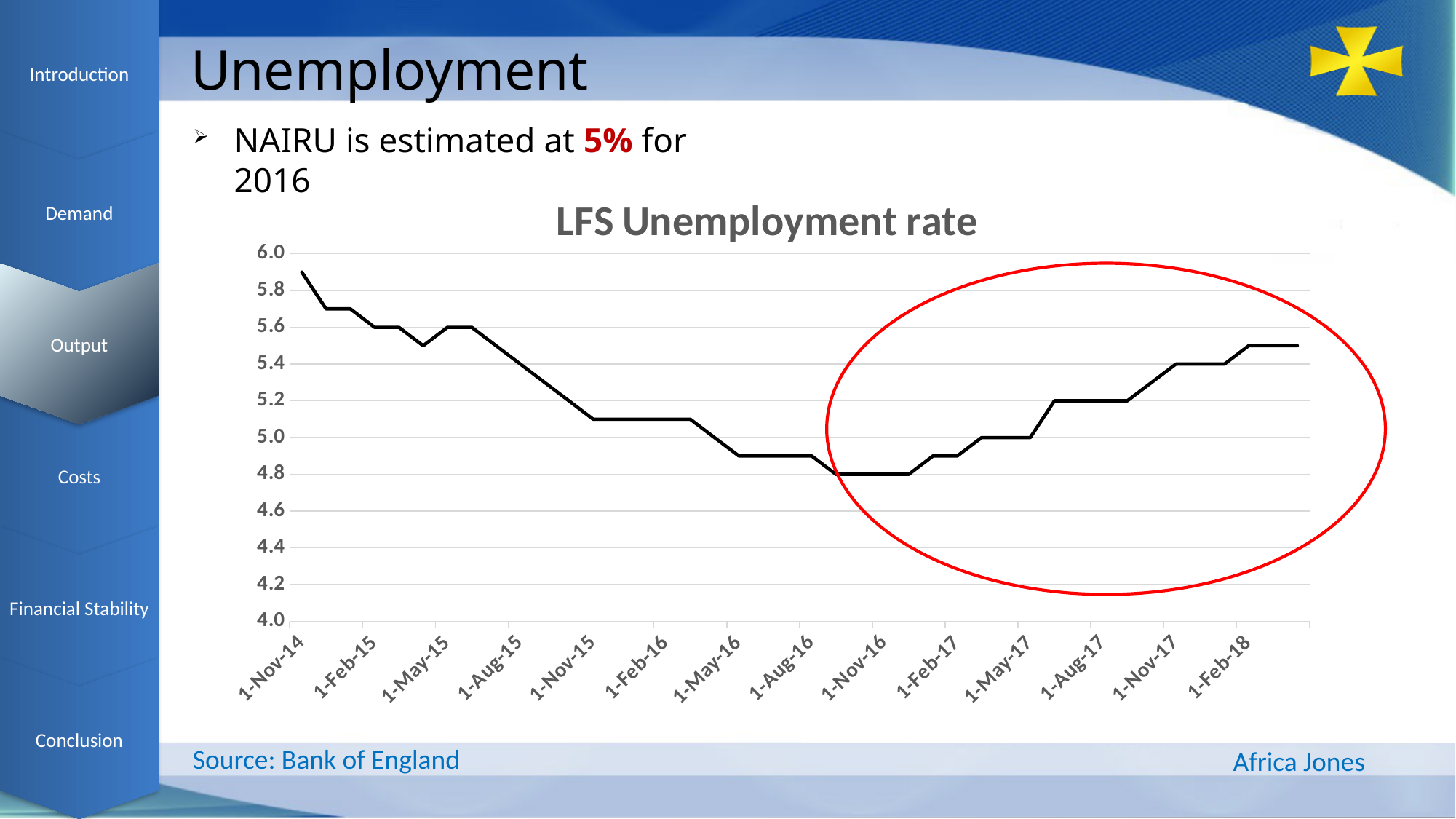
What is the highest value shown on the chart's vertical axis? 6.0 What type of chart is shown on the slide? line chart Is the unemployment rate at 1-Nov-14 greater or less than 5.8? greater Which is larger, the unemployment rate at 1-Nov-14 or at 1-Feb-18? 1-Nov-14 At which labelled date is the unemployment rate highest? 1-Nov-14 Is the unemployment rate at 1-May-16 greater or less than 5.0? less Does the unemployment rate rise or fall between 1-Nov-16 and 1-Feb-18? rise Is the unemployment rate at 1-Nov-16 greater or less than 5.0? less What is the lowest unemployment rate reached on the chart? 4.8 What is the title of the chart? LFS Unemployment rate